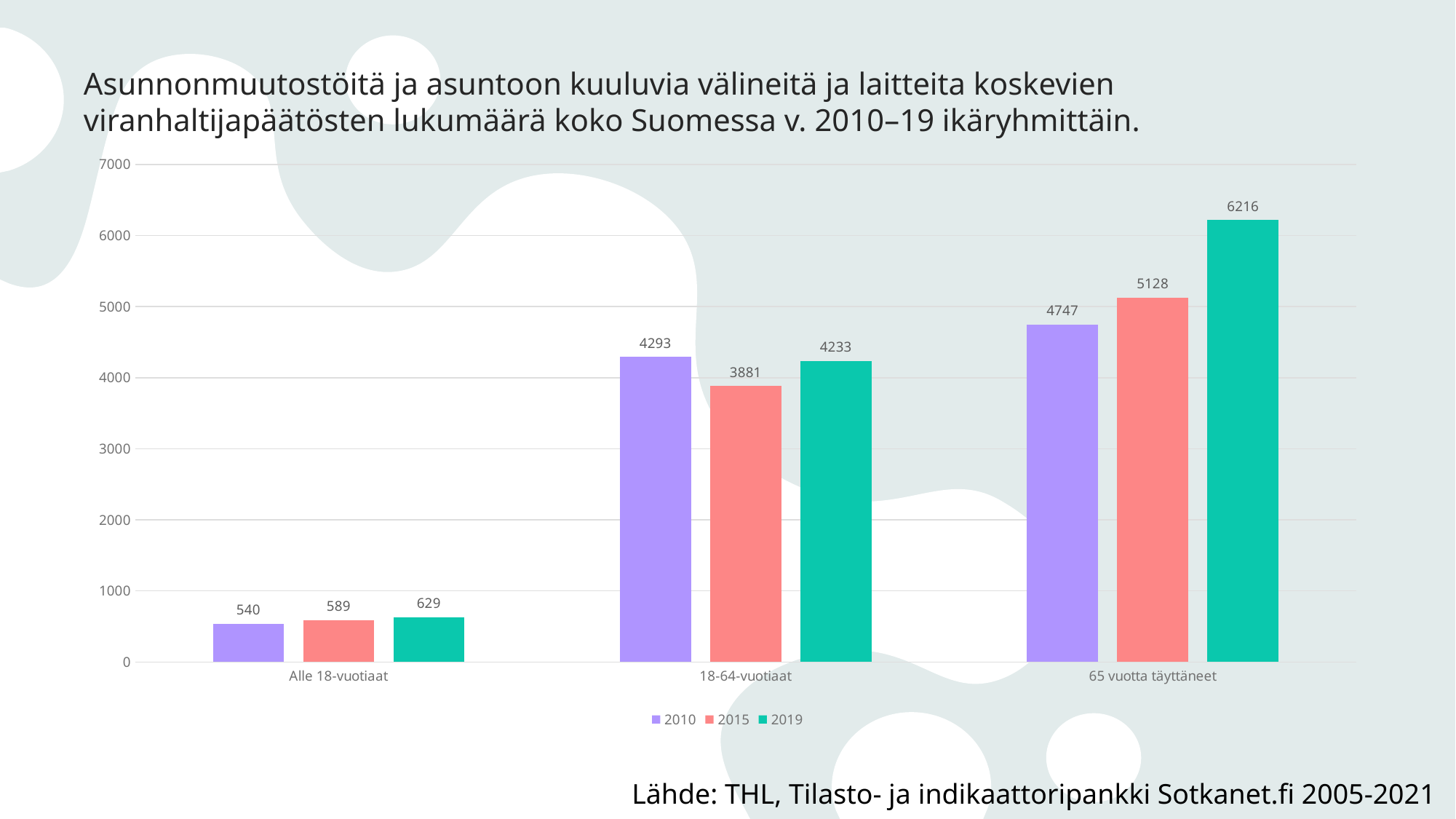
Which category has the lowest value for the 2010 series? Alle 18-vuotiaat What is the difference between the 2010 and 2015 values for '18-64-vuotiaat'? 412 What kind of chart is shown on the slide? Bar chart What is the value for 2015 in the '18-64-vuotiaat' category? 3881 What is the value for 2019 in the '65 vuotta täyttäneet' category? 6216 What is the value for 2010 in the 'Alle 18-vuotiaat' category? 540 How many categories are shown on the x axis? 3 How many series does the legend list? 3 Which category has the highest value for the 2019 series? 65 vuotta täyttäneet Which is larger for '18-64-vuotiaat': the 2010 value or the 2019 value? 2010 Which series is shown in purple in the legend? 2010 What is the difference between the 2019 and 2010 values for '65 vuotta täyttäneet'? 1469